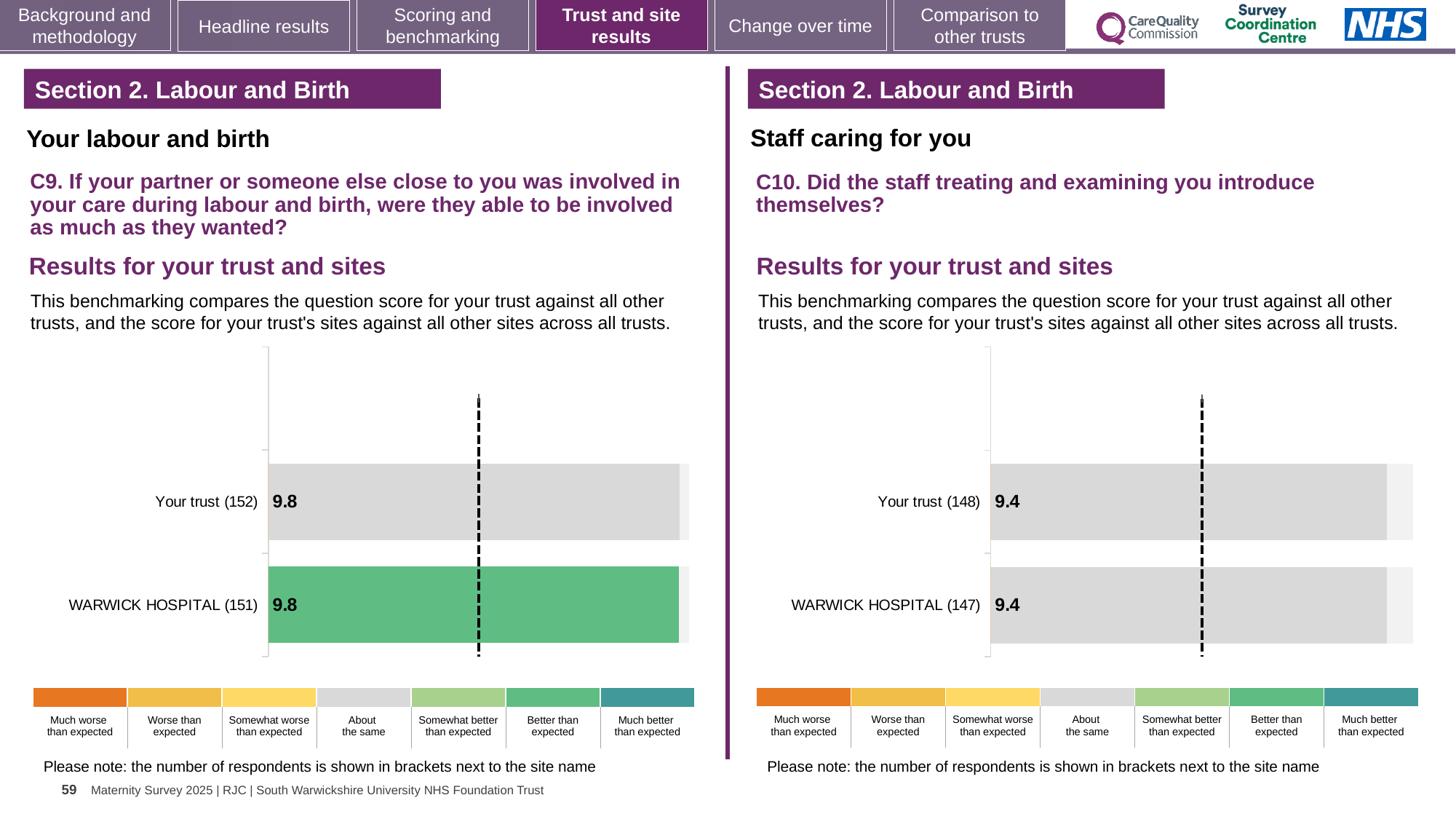
In the C10 chart on the right, what is the score for Your trust (148)? 9.4 In the C10 chart on the right, is the score for Your trust larger than, smaller than, or equal to the score for WARWICK HOSPITAL? equal In the C9 chart on the left, which benchmark category does the green colour of the WARWICK HOSPITAL bar correspond to? Better than expected What kind of chart is used for the C9 results on the left? Bar chart How many benchmark categories are shown in the colour key below the C10 chart on the right? 7 How many bars are plotted in the C9 chart on the left? 2 In the C10 chart on the right, what is the score for WARWICK HOSPITAL (147)? 9.4 How many bars are plotted in the C10 chart on the right? 2 In the C9 chart on the left, what is the score for Your trust (152)? 9.8 In the C9 chart on the left, what is the score for WARWICK HOSPITAL (151)? 9.8 In the C9 chart on the left, what is the difference between the score for Your trust and the score for WARWICK HOSPITAL? 0 Is the score for WARWICK HOSPITAL in the C10 chart on the right greater or less than the score for WARWICK HOSPITAL in the C9 chart on the left? less